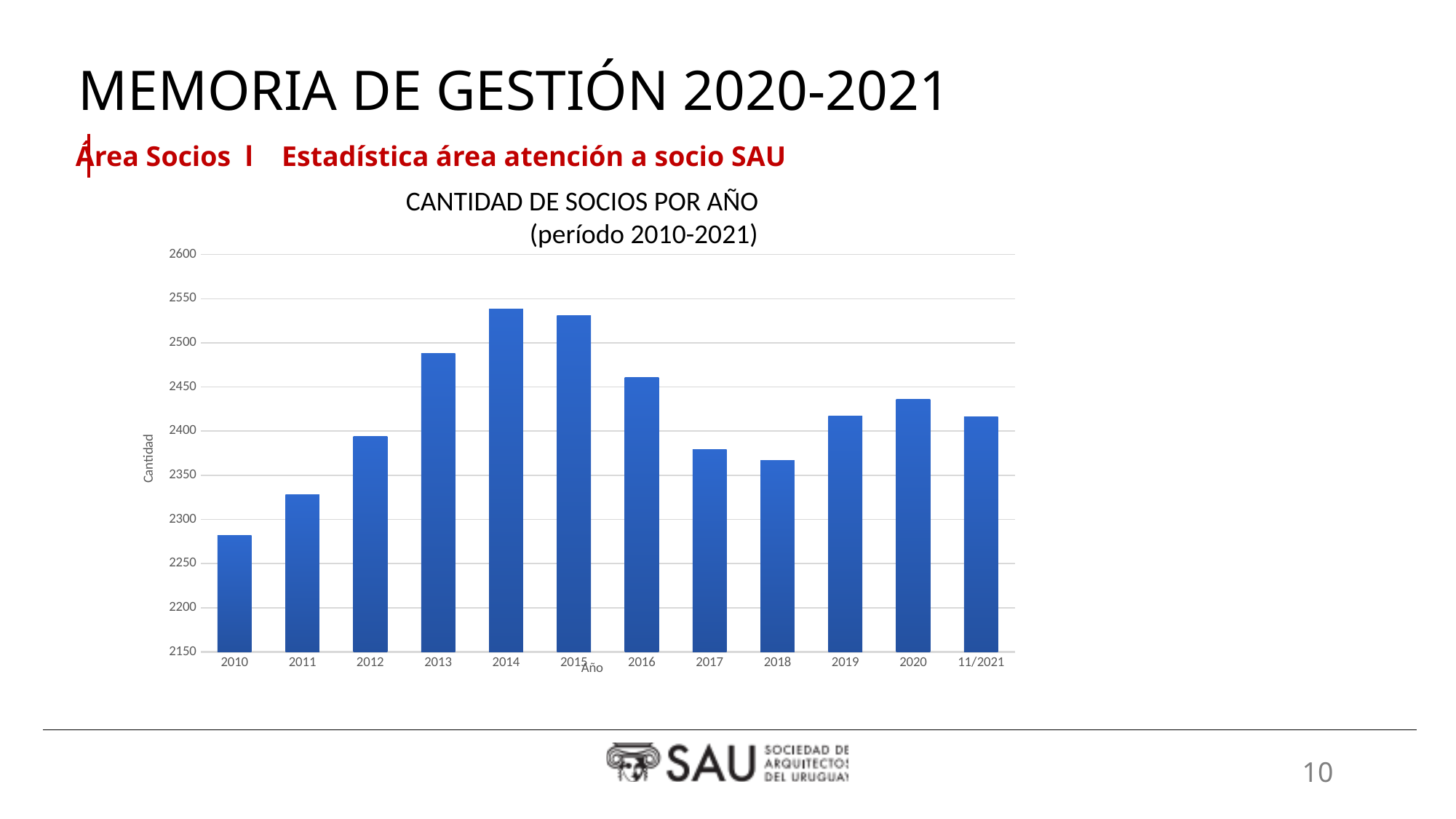
Do the values rise or fall from 2010 to 2014? rise Which is larger, the value for 2019 or the value for 2017? 2019 Is the value for 2014 greater or less than 2500? greater What kind of chart is shown on the slide? bar chart Which year has the lowest number of socios? 2010 What is the label on the vertical axis of the chart? Cantidad Is the value for 2010 greater or less than 2300? less How many bars (years) are plotted in the chart? 12 Is the value for 2013 greater or less than 2500? less Which is larger, the value for 2013 or the value for 2016? 2013